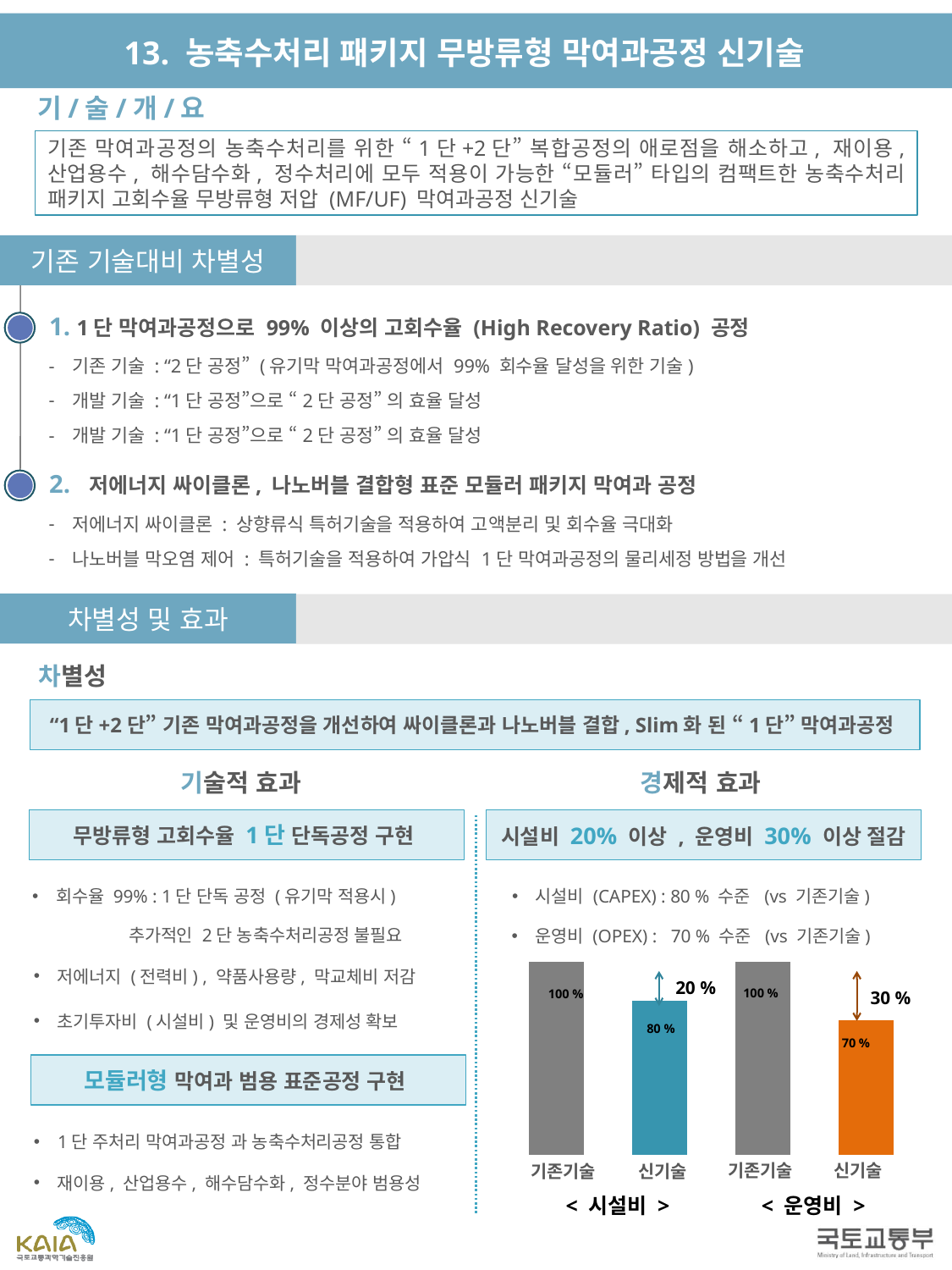
In the 운영비 chart, which category has the higher value? 기존기술 In the 운영비 chart, what is the value for 신기술? 70 % In the 시설비 chart, what is the value for 기존기술? 100 % How many bars does the 시설비 chart have? 2 In the 시설비 chart, which category has the lower value? 신기술 In the 운영비 chart, what is the difference between 기존기술 and 신기술? 30 % What colour is the 신기술 bar in the 운영비 chart? orange What kind of chart is the 운영비 chart? bar chart Which is larger: the 신기술 value in the 시설비 chart or the 신기술 value in the 운영비 chart? 시설비 chart (80 %) In the 시설비 chart, what is the difference between 기존기술 and 신기술? 20 % In the 운영비 chart, what is the value for 기존기술? 100 % In the 시설비 chart, what is the value for 신기술? 80 %